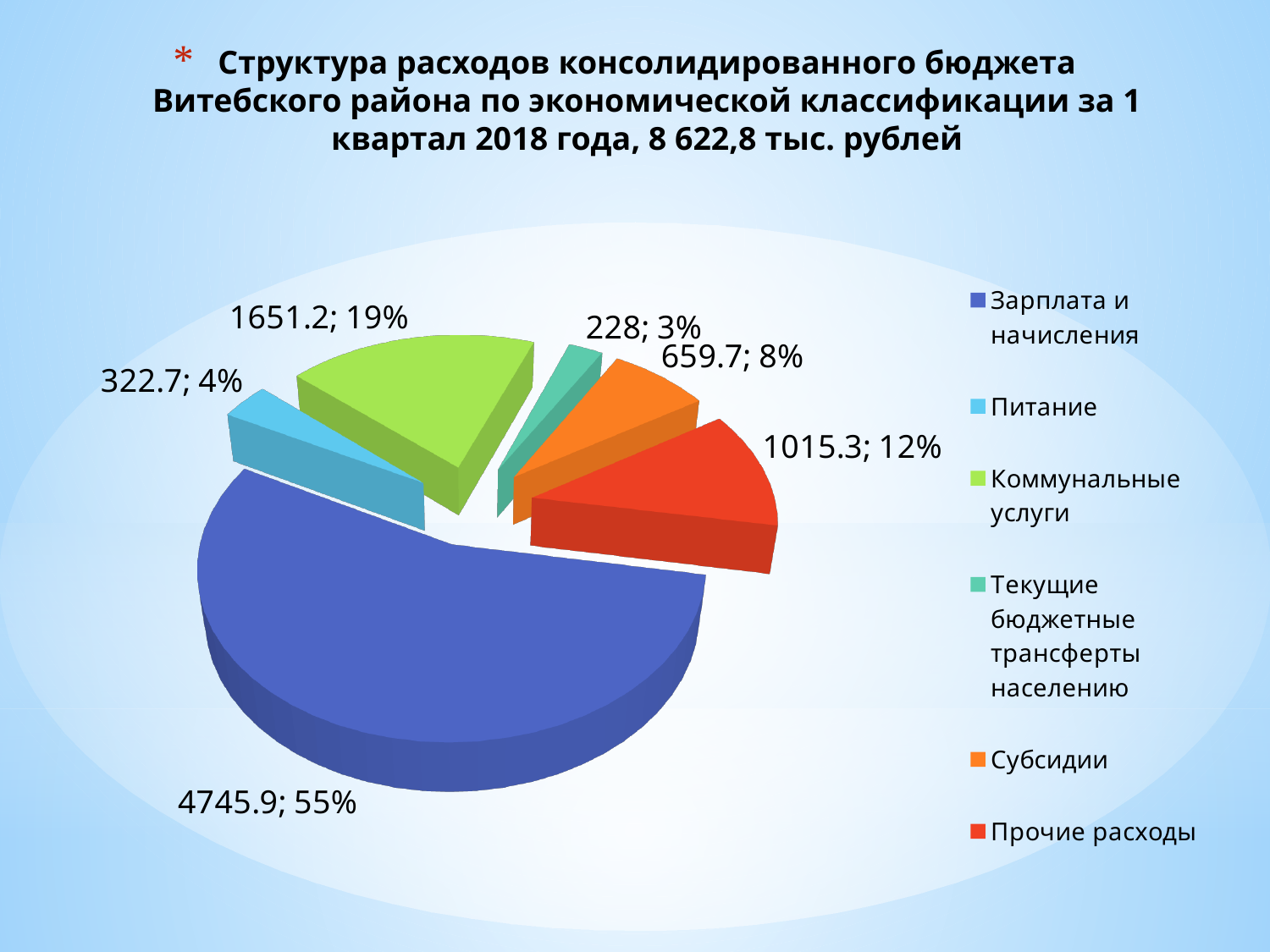
Which category has the smallest slice? Текущие бюджетные трансферты населению What kind of chart is shown on the slide? Pie chart Which category has the largest slice? Зарплата и начисления What is the value for Зарплата и начисления? 4745.9 What is the difference between the values for Коммунальные услуги and Прочие расходы? 635.9 What share of the pie does Субсидии take? 8% What is the value for Прочие расходы? 1015.3 How many slices does the pie chart have? 6 Which is larger, the value for Субсидии or the value for Питание? Субсидии What share of the pie does Коммунальные услуги take? 19% What colour is the slice for Питание? Light blue What share of the pie does Текущие бюджетные трансферты населению take? 3%